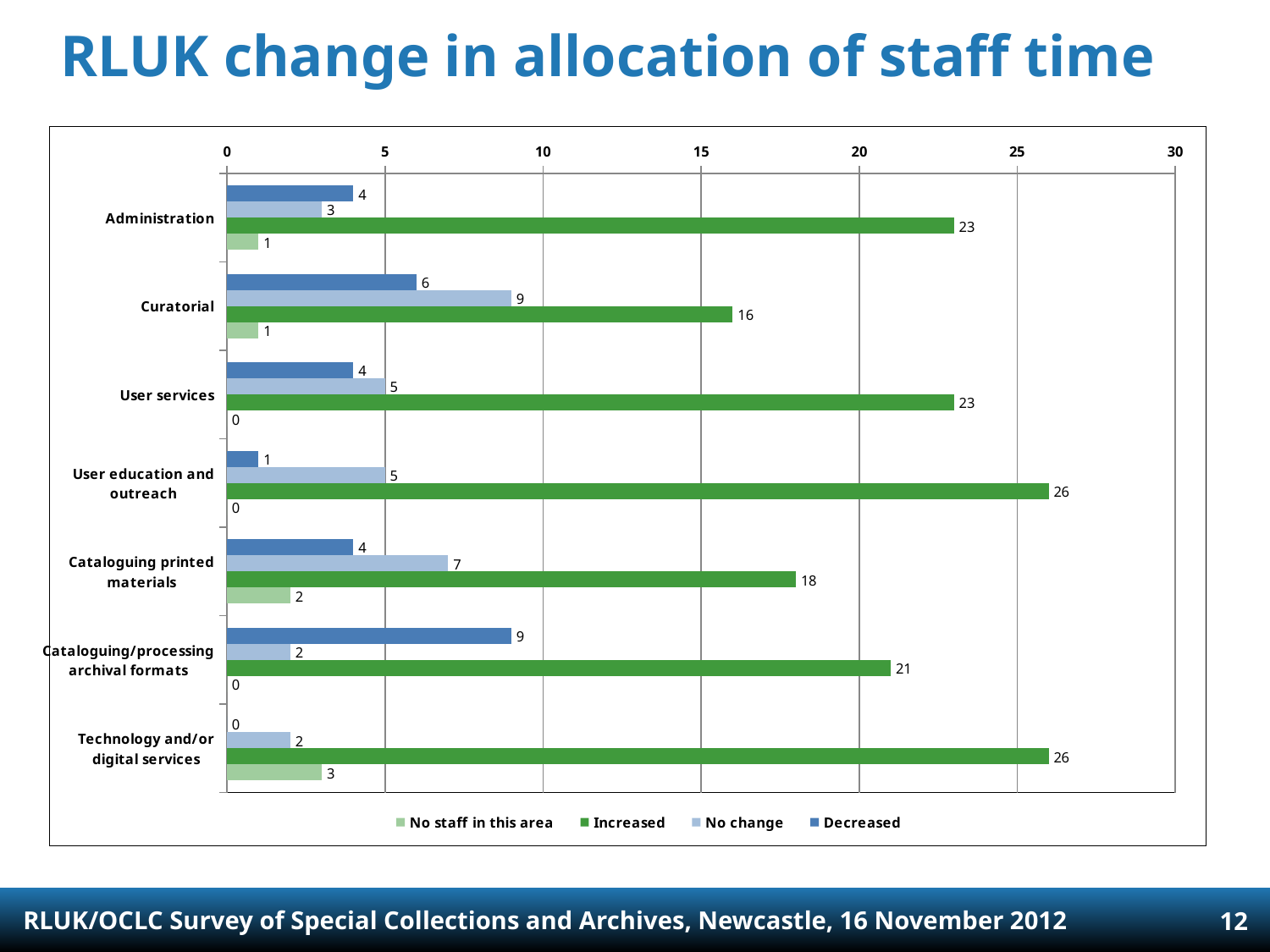
How many series does the legend list? 4 What is the value for No staff in this area in the Technology and/or digital services category? 3 What is the value for No change in the Curatorial category? 9 Which is larger: the Increased value for Curatorial or the Increased value for Cataloguing/processing archival formats? Cataloguing/processing archival formats Which category has the lowest value for Increased? Curatorial What is the title of the slide? RLUK change in allocation of staff time What is the value for Decreased in the Cataloguing/processing archival formats category? 9 What is the difference between the Increased values for User education and outreach and Cataloguing printed materials? 8 How many categories are shown on the chart? 7 Which category has the highest value for Decreased? Cataloguing/processing archival formats What kind of chart is shown on the slide? Bar chart What is the value for Increased in the Administration category? 23